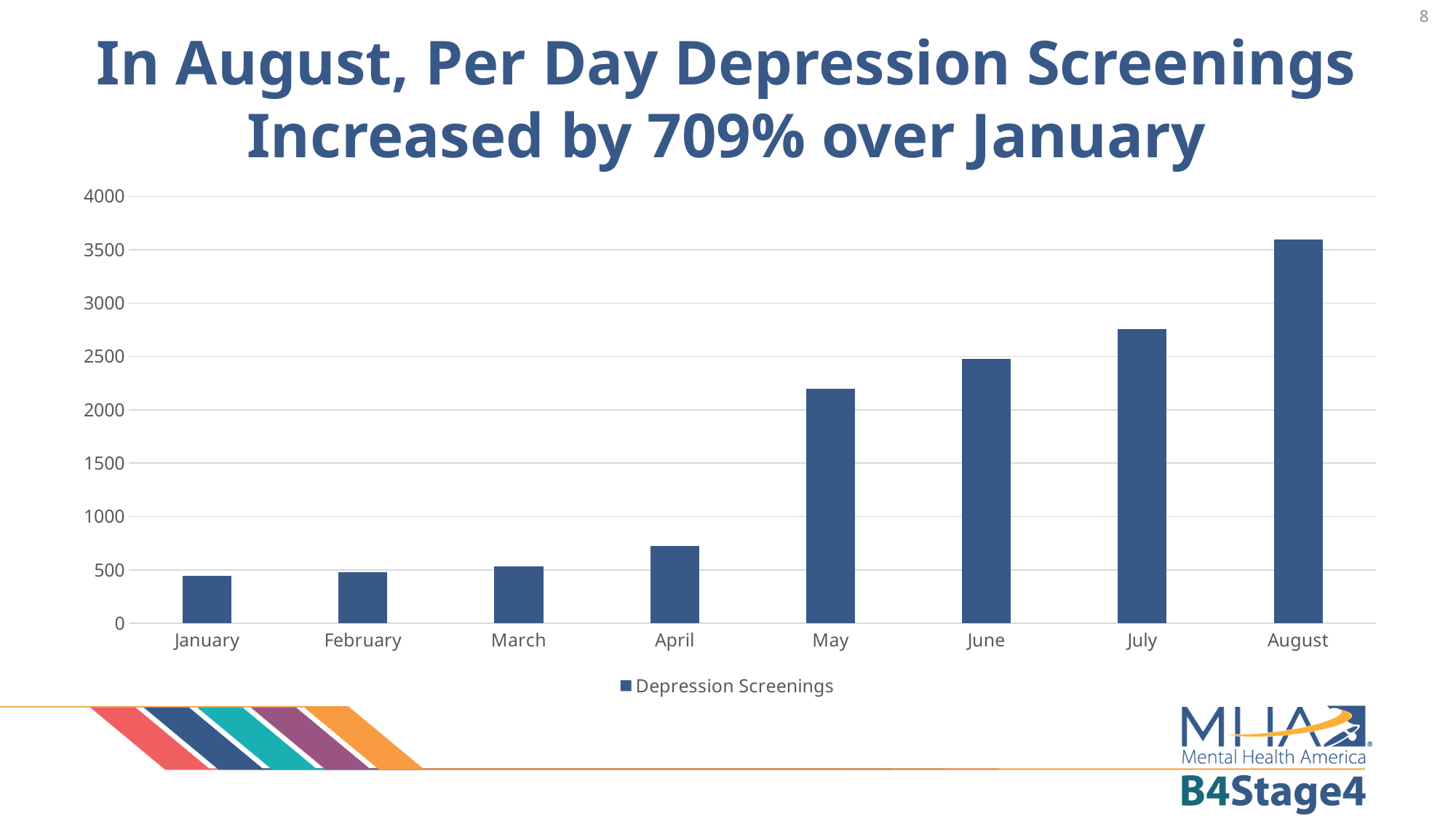
Do the depression screening values generally rise or fall from January to August? rise What kind of chart is shown on the slide? bar chart How many months are shown on the x axis of the chart? 8 Is the value for May greater or less than 2000? greater Is the value for July greater or less than 2500? greater What is the name of the series shown in the chart legend? Depression Screenings Which month has more depression screenings, April or May? May Is the value for January greater or less than 500? less Which month has the lowest number of depression screenings? January How many series does the chart legend list? 1 Which month has the highest number of depression screenings? August